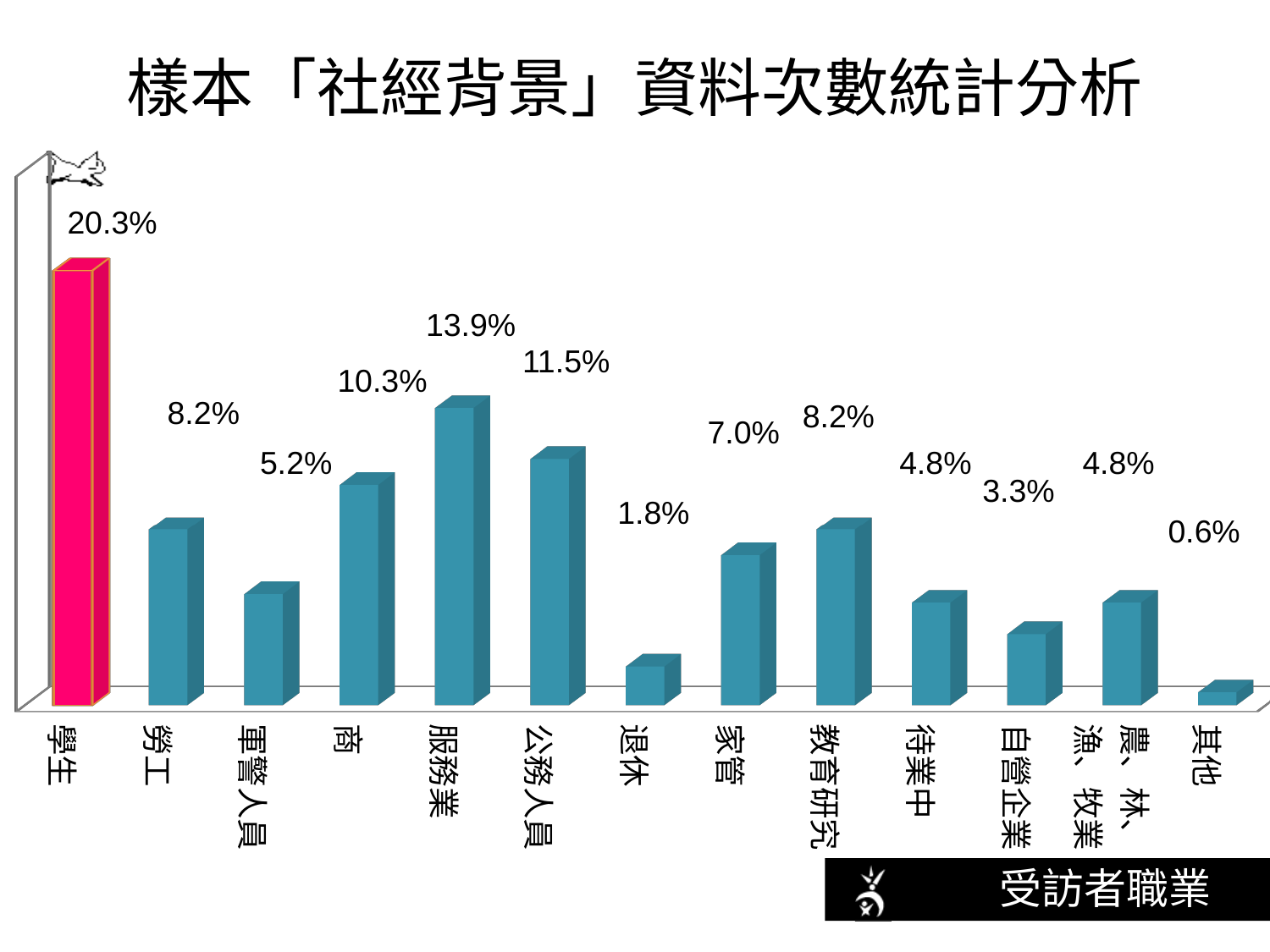
Which category has the lowest value? 其他 Which bar is shown in a different colour (pink/red) from the others? 學生 What is the value for 退休? 1.8% Which category has the highest value? 學生 How many categories are shown in the chart? 13 What is the value for 學生? 20.3% What is the title of the slide? 樣本「社經背景」資料次數統計分析 What is the difference between the values for 學生 and 服務業? 6.4% What is the value for 服務業? 13.9% What kind of chart is shown on the slide? Bar chart What is the value for 自營企業? 3.3% Which is larger, the value for 商 or the value for 公務人員? 公務人員